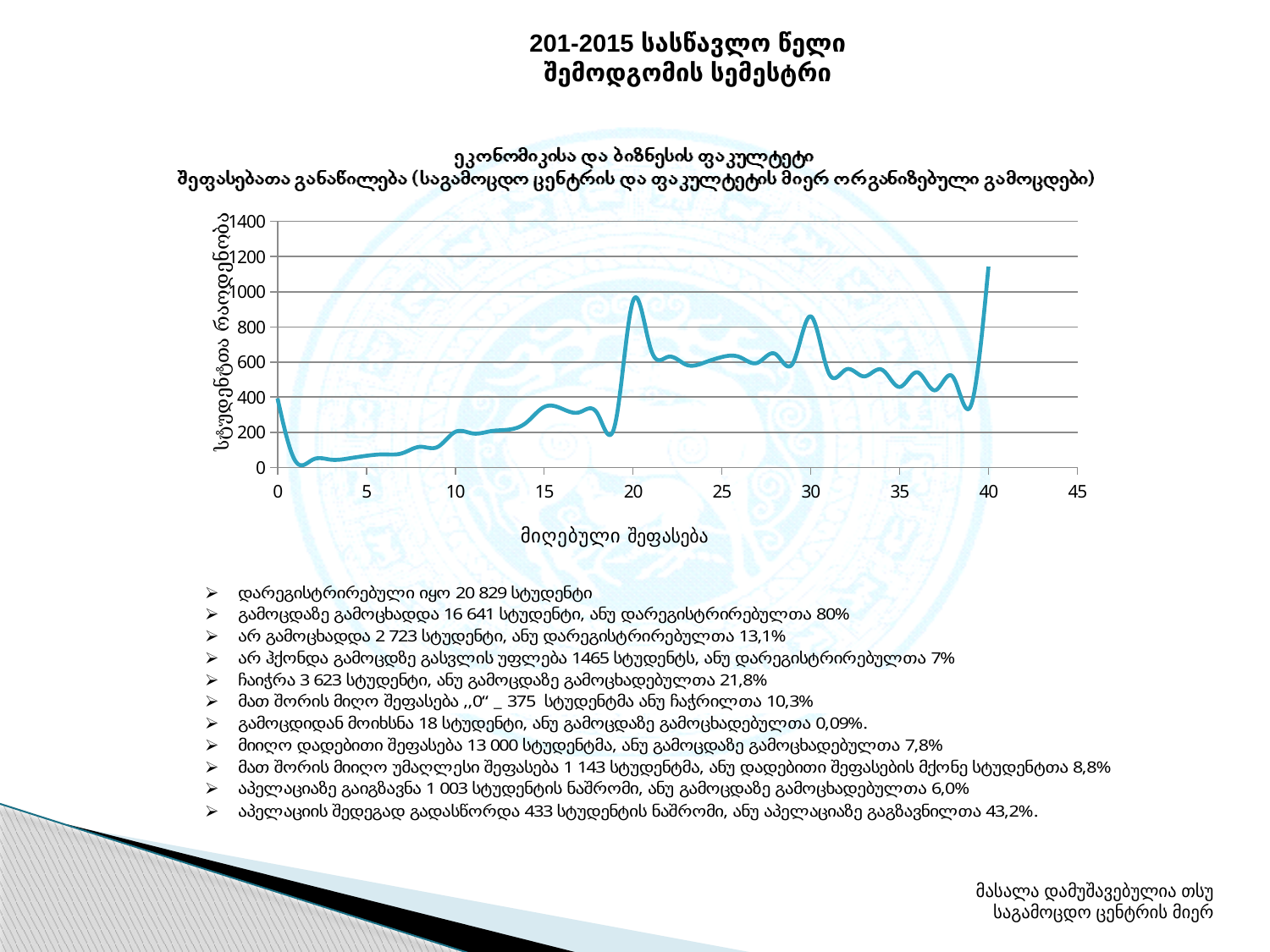
What is the title of the y axis of the chart? სტუდენტთა რაოდენობა At which score on the x axis does the line reach its highest value? 40 Is the value of the line at a score of 0 greater or less than 600? less Is the value of the line higher at a score of 20 or at a score of 10? 20 Is the value of the line at a score of 10 greater or less than 400? less What kind of chart is shown on the slide? line chart Is the value of the line at a score of 40 greater or less than 1000? greater What is the title of the x axis of the chart? მიღებული შეფასება Does the line rise or fall between scores 10 and 15? rise